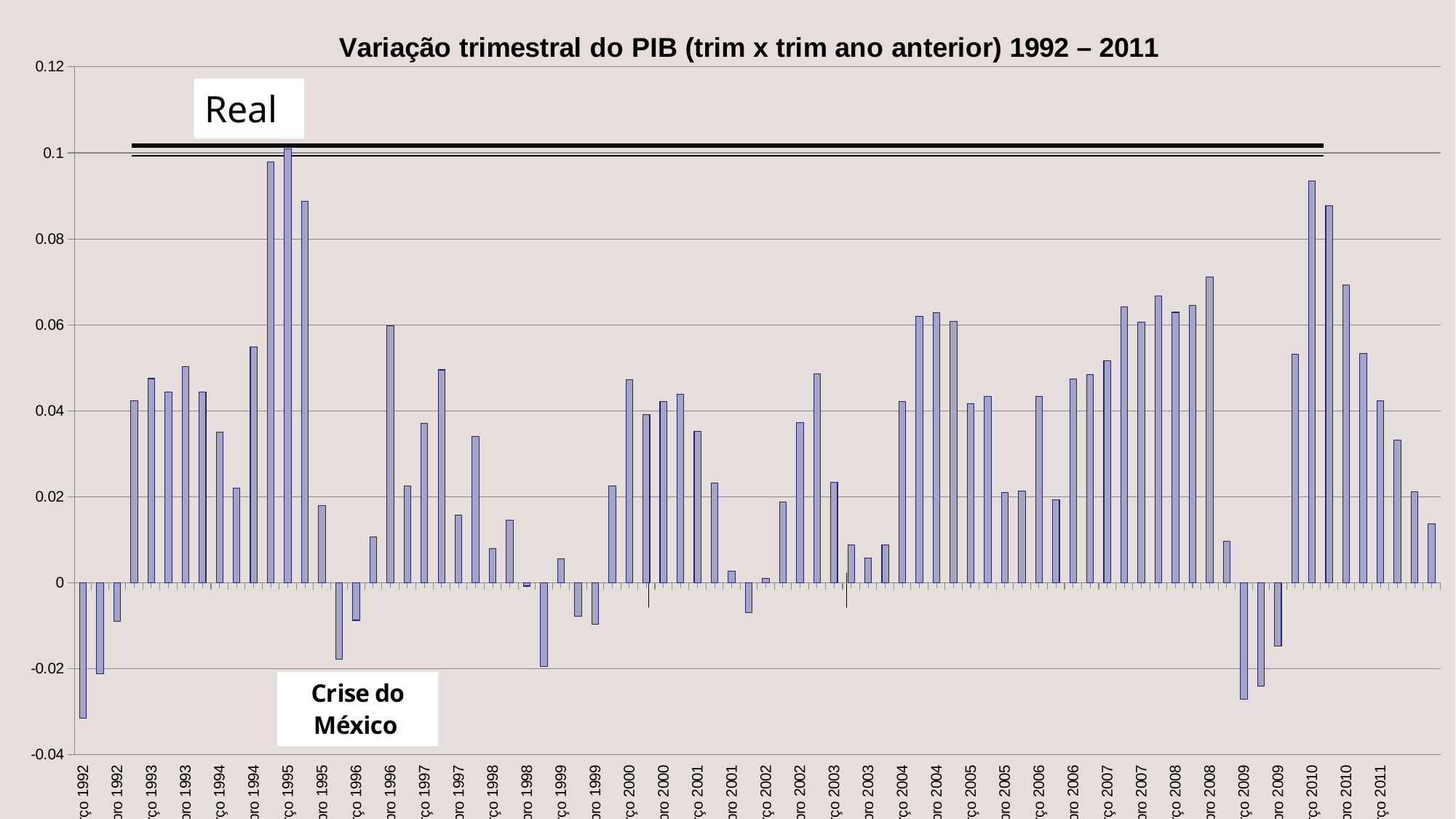
In which year does the tallest bar of the chart occur? 1995 Is the tallest bar in 1995 greater or less than 0.08? greater What text is shown in the box placed below the negative bars around 1995–1996? Crise do México Is the value of the leftmost bar (1992) greater or less than -0.02? less Which is taller: the tallest bar in 1995 or the tallest bar in 2010? The tallest bar in 1995 Which bar has the lowest value in the chart? The leftmost bar (1992) What type of chart is shown on the slide? Bar chart Is the tallest bar in 2008 greater or less than 0.06? greater What is the title of the chart? Variação trimestral do PIB (trim x trim ano anterior) 1992 – 2011